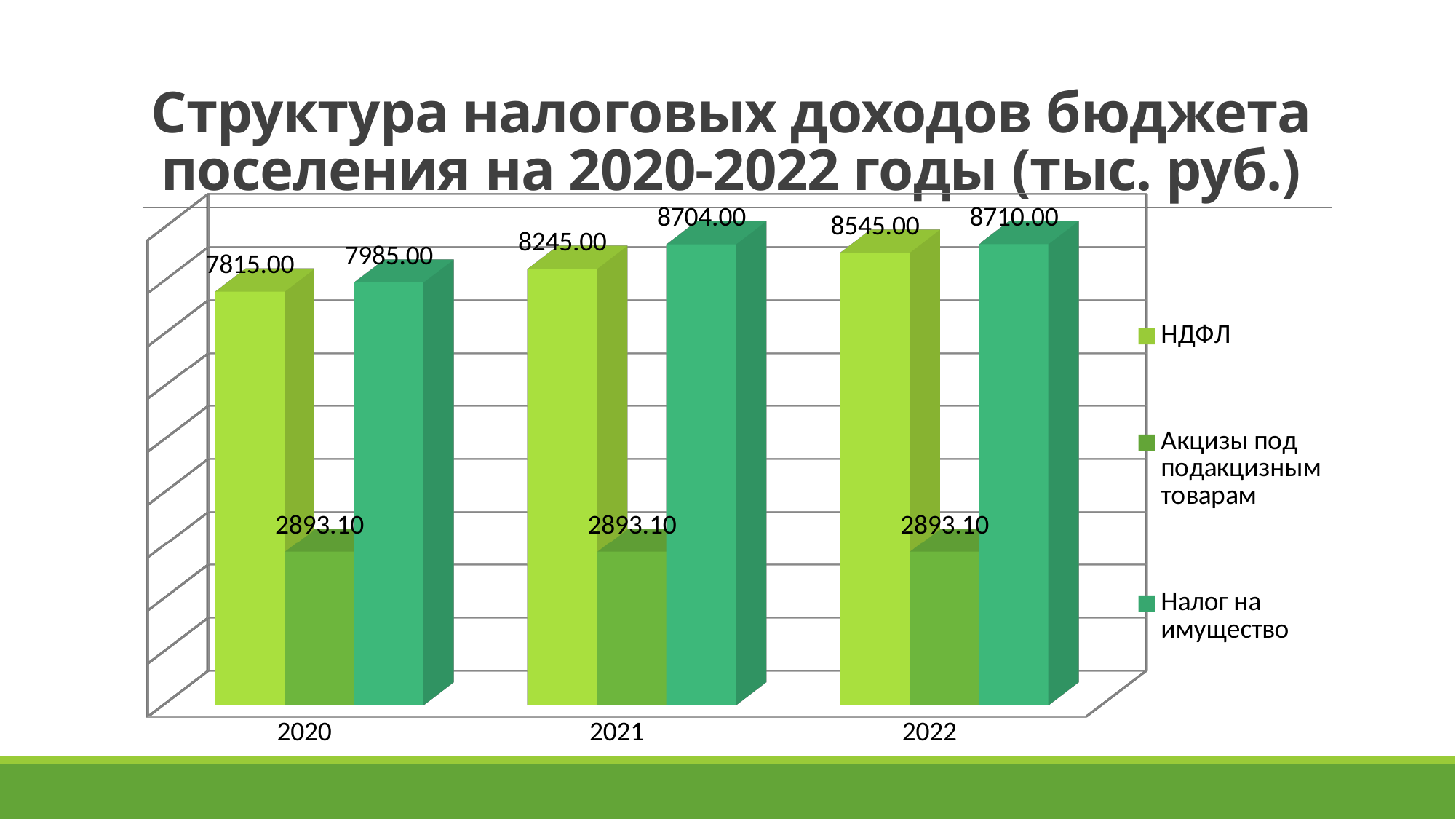
What is the value for Акцизы под подакцизным товарам in 2022? 2893.10 What is the value for НДФЛ in 2020? 7815.00 How many years are shown on the x axis? 3 Which series has the lowest value in 2021? Акцизы под подакцизным товарам Does the value for НДФЛ rise or fall from 2020 to 2022? rise What is the difference between Налог на имущество and НДФЛ in 2022? 165.00 How many series does the legend list? 3 In which year is the value for НДФЛ the highest? 2022 Which is larger in 2020: НДФЛ or Налог на имущество? Налог на имущество What is the value for Налог на имущество in 2021? 8704.00 What is the difference between the НДФЛ values for 2022 and 2020? 730.00 What is the value for Налог на имущество in 2022? 8710.00